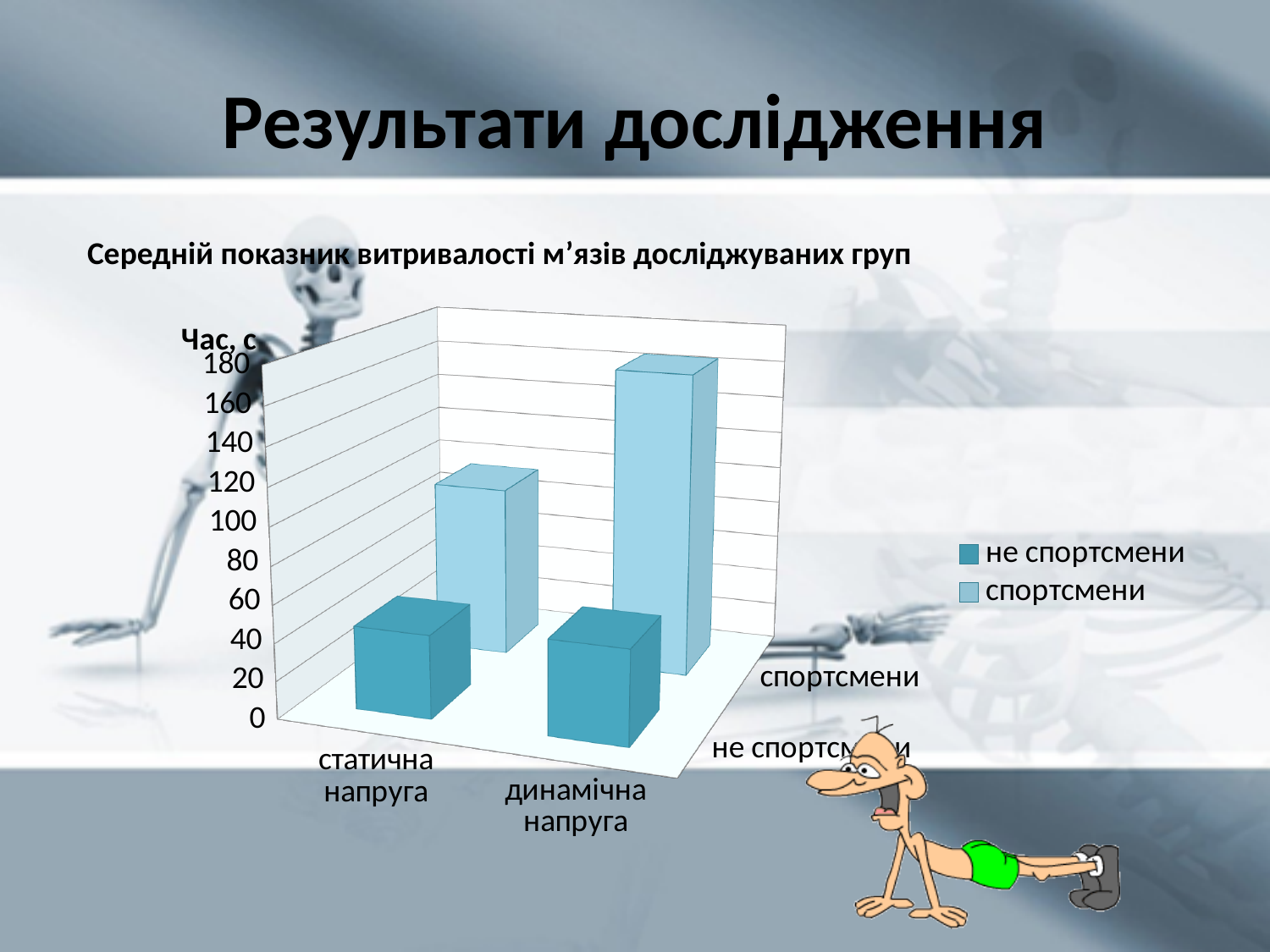
Is the value for спортсмени under динамічна напруга greater or less than 140? greater How many categories are shown on the x axis of the chart? 2 How many series does the chart legend list? 2 Is the value for не спортсмени under статична напруга greater or less than 100? less What kind of chart is shown on the slide? bar chart Under динамічна напруга, which series has the larger value: спортсмени or не спортсмени? спортсмени For the спортсмени series, does the value rise or fall from статична напруга to динамічна напруга? rise Is the value for не спортсмени under динамічна напруга greater or less than 100? less Which bar in the chart is the highest? спортсмени, динамічна напруга What is the title of the chart? Середній показник витривалості м’язів досліджуваних груп Under статична напруга, which series has the larger value: спортсмени or не спортсмени? спортсмени